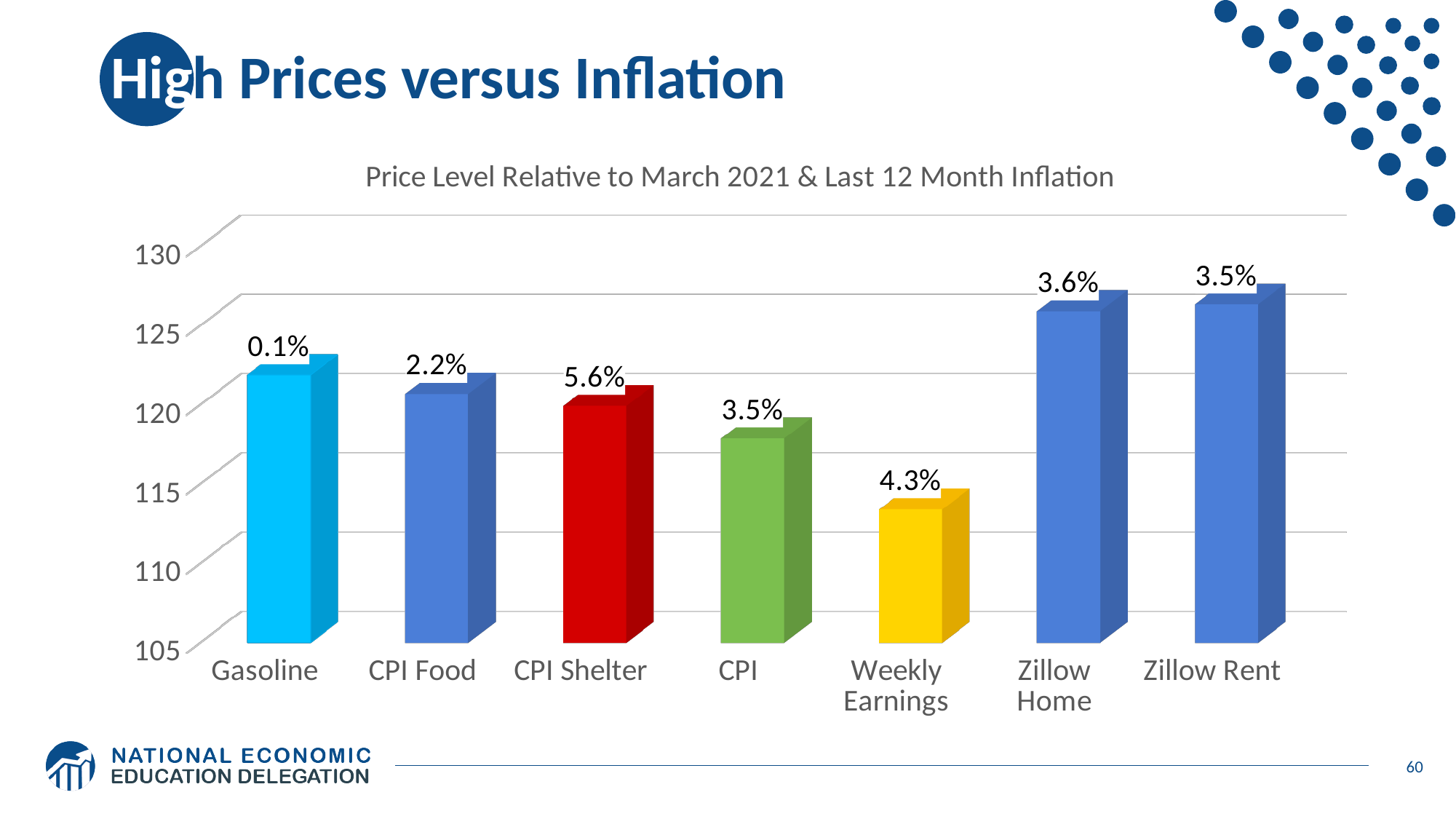
Which category has the lowest 12-month inflation label? Gasoline What 12-month inflation label is shown above the Zillow Home bar? 3.6% Is the price level bar for Weekly Earnings greater or less than 115? less What 12-month inflation label is shown above the Weekly Earnings bar? 4.3% What 12-month inflation label is shown above the CPI Shelter bar? 5.6% Which category has the lowest bar (price level) on the chart? Weekly Earnings What is the difference between the inflation labels for CPI Shelter and CPI Food? 3.4% What is the title of the chart? Price Level Relative to March 2021 & Last 12 Month Inflation Is the price level bar for Zillow Home greater or less than 125? greater Which category has the highest 12-month inflation label? CPI Shelter How many categories are shown on the chart? 7 What 12-month inflation label is shown above the Gasoline bar? 0.1%